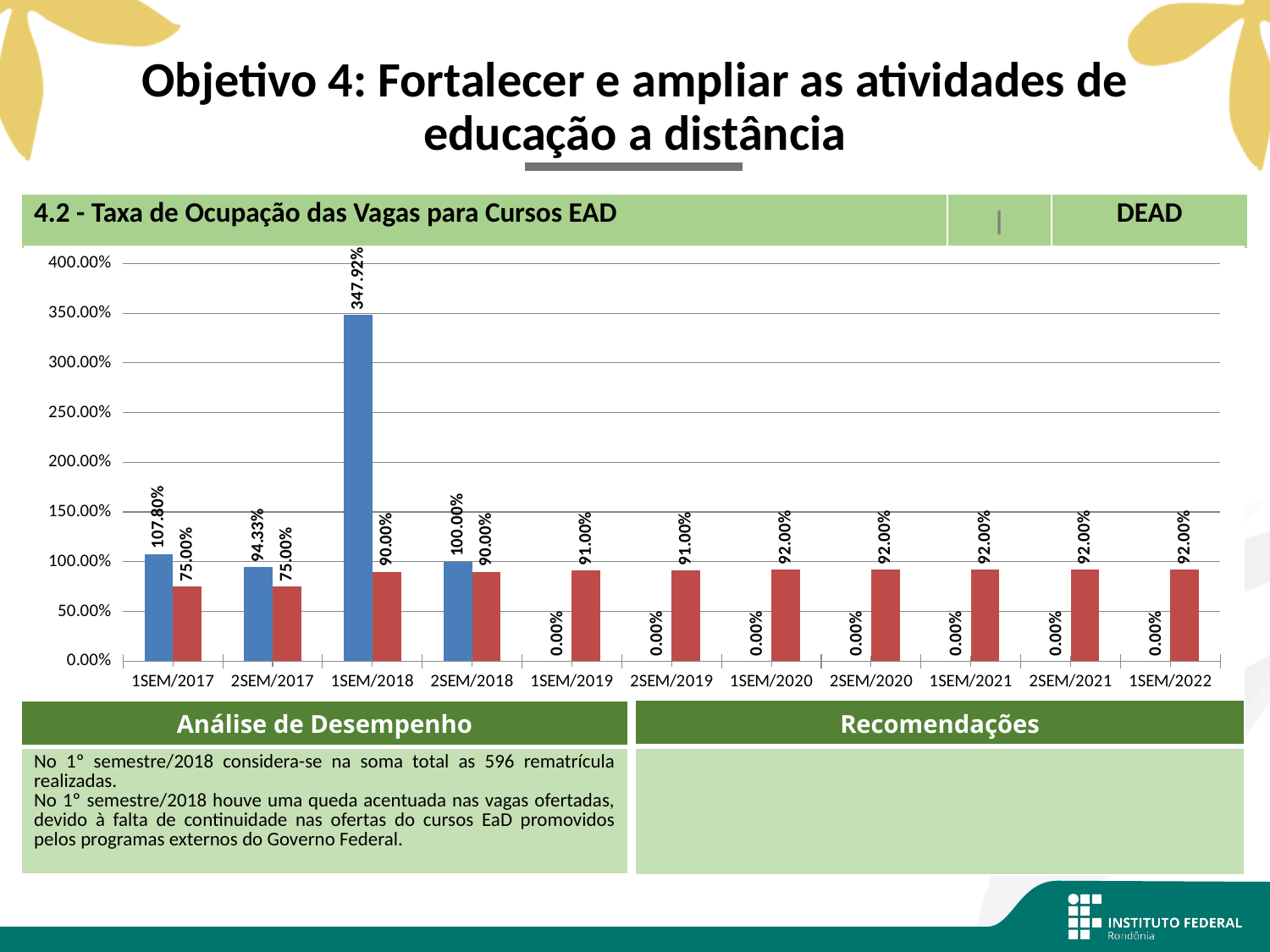
What kind of chart is shown on the slide? Bar chart How many categories (semesters) are shown on the x axis? 11 What is the title of the chart? 4.2 - Taxa de Ocupação das Vagas para Cursos EAD What is the value of the blue bar for 2SEM/2017? 94.33% What is the value of the blue bar for 1SEM/2018? 347.92% What is the value of the red bar for 1SEM/2017? 75.00% Which category has the highest blue bar? 1SEM/2018 What is the difference between the blue bar and the red bar for 1SEM/2017? 32.80% What is the difference between the blue bar values for 1SEM/2018 and 2SEM/2018? 247.92% Which category has the lowest red bar value, 1SEM/2017 or 1SEM/2018? 1SEM/2017 Is the blue bar for 1SEM/2018 greater or less than 300.00%? greater What is the value of the red bar for 1SEM/2022? 92.00%